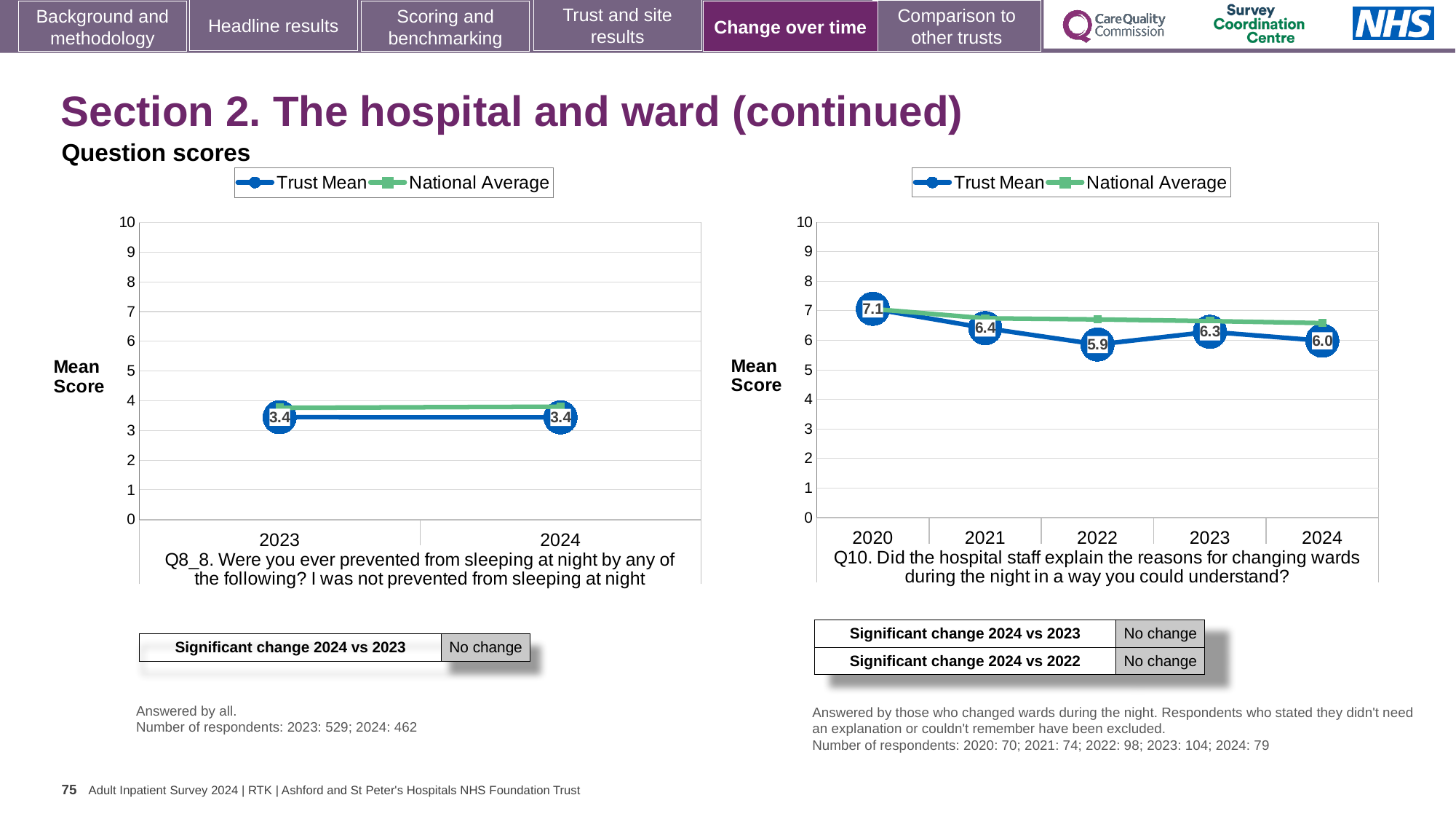
In the Q10 chart on the right, what is the Trust Mean score for 2020? 7.1 In the Q8_8 chart on the left, what is the Trust Mean score for 2024? 3.4 What type of chart is the Q10 chart on the right? Line chart In the Q10 chart on the right, which year has the highest Trust Mean score? 2020 In the Q10 chart on the right, what is the Trust Mean score for 2022? 5.9 In the Q10 chart on the right, how many series does the legend list? 2 In the Q8_8 chart on the left, is the Trust Mean value for 2024 greater or less than 5? less In the Q10 chart on the right, is the Trust Mean score for 2021 or 2023 larger? 2021 In the Q8_8 chart on the left, what is the Trust Mean score for 2023? 3.4 In the Q10 chart on the right, which year has the lowest Trust Mean score? 2022 In the Q8_8 chart on the left, how many years are shown on the x axis? 2 In the Q10 chart on the right, what is the difference between the Trust Mean scores for 2020 and 2024? 1.1